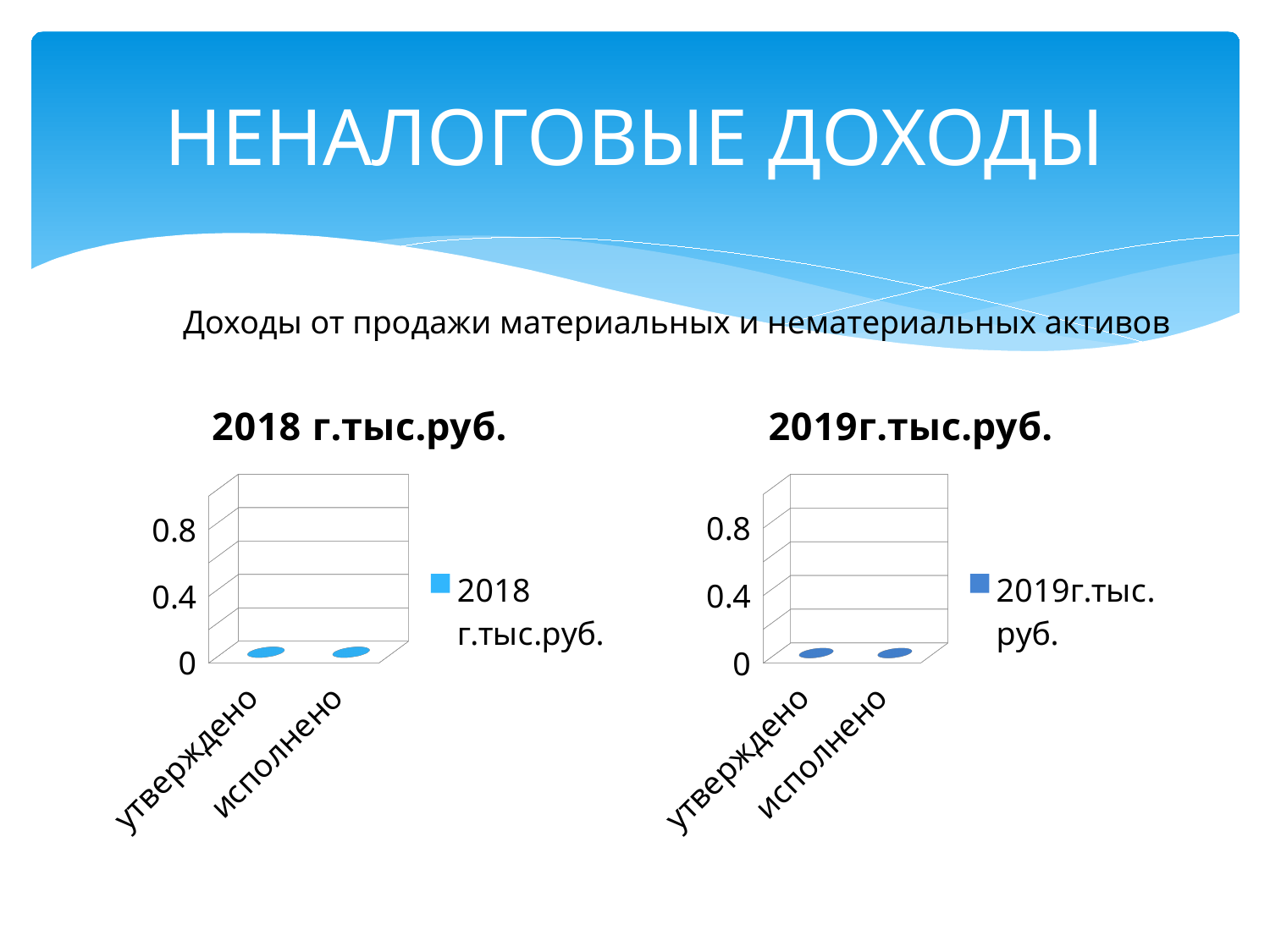
In the "2019г.тыс.руб." chart, is the value for исполнено greater or less than 0.4? less In the "2018 г.тыс.руб." chart, is the value for исполнено greater or less than 0.8? less How many series does the legend of the "2018 г.тыс.руб." chart list? 1 How many categories are shown on the x axis of the "2019г.тыс.руб." chart? 2 In the "2018 г.тыс.руб." chart, is the value for утверждено greater or less than 0.4? less What is the legend entry of the "2019г.тыс.руб." chart? 2019г.тыс.руб. What kind of chart is the "2019г.тыс.руб." chart? bar chart What kind of chart is the "2018 г.тыс.руб." chart? bar chart How many categories are shown on the x axis of the "2018 г.тыс.руб." chart? 2 What is the title of the left chart on the slide? 2018 г.тыс.руб. How many series does the legend of the "2019г.тыс.руб." chart list? 1